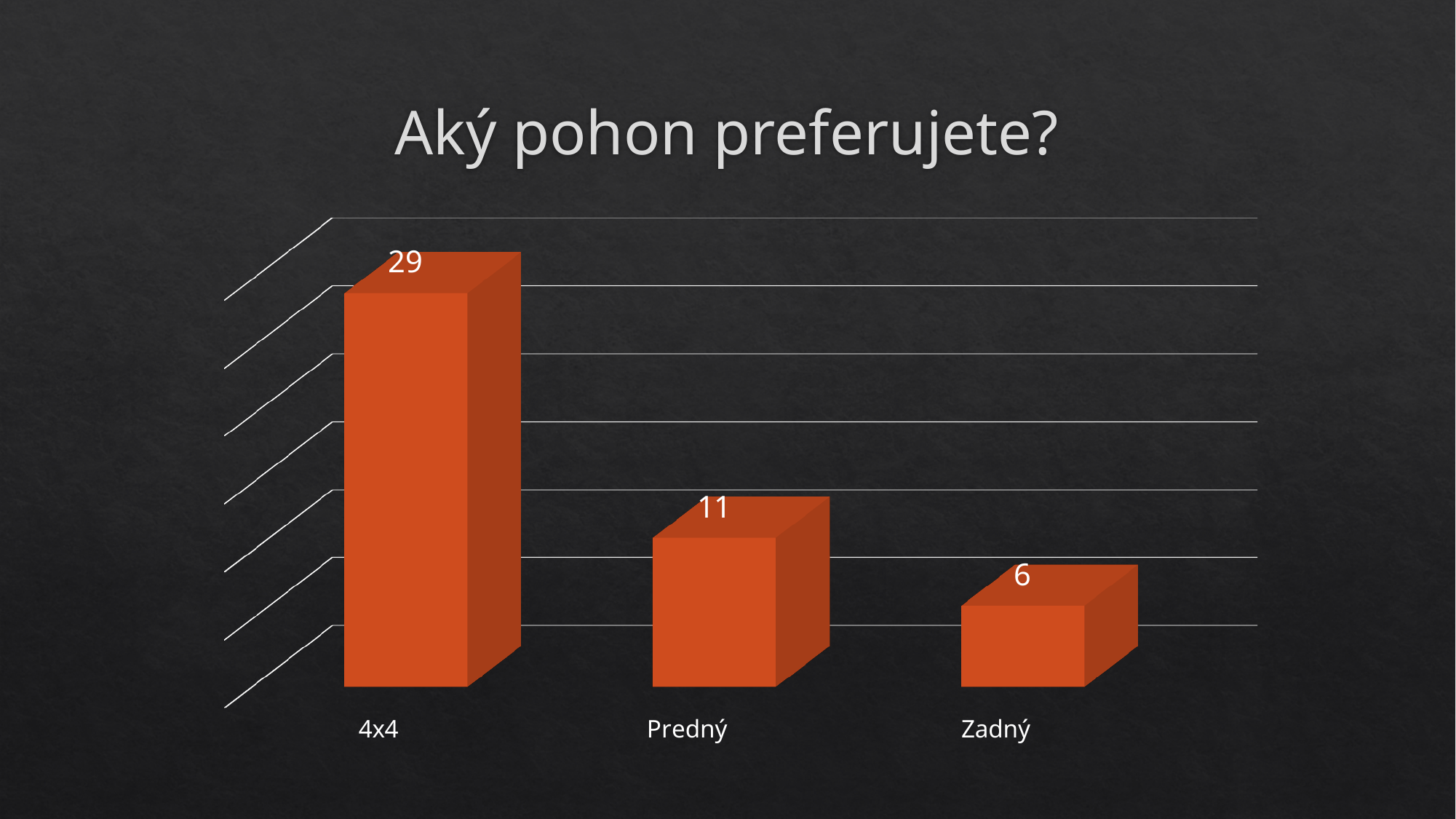
What is the value for Zadný? 6 Which category has the highest value? 4x4 What kind of chart is shown on the slide? bar chart Which is larger, the value for Predný or the value for Zadný? Predný What is the difference between the values for 4x4 and Predný? 18 What is the value for 4x4? 29 What is the title of the chart? Aký pohon preferujete? Which category has the lowest value? Zadný Do the values rise or fall from left to right across the categories? fall What is the value for Predný? 11 How many categories are shown on the chart? 3 What is the difference between the values for Predný and Zadný? 5